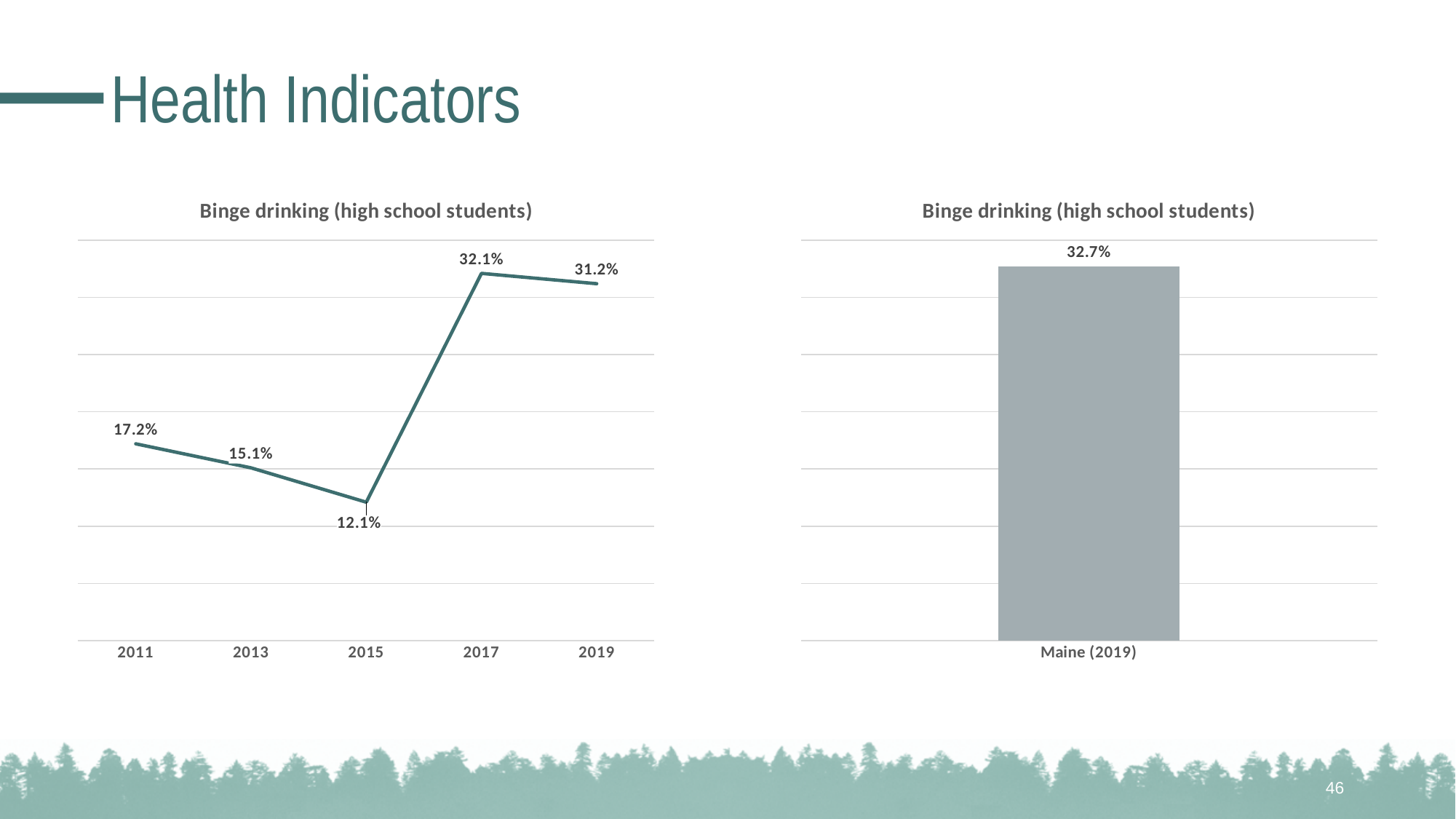
In the left chart, which is larger, the value for 2013 or the value for 2019? 2019 In the left chart, which year has the highest value? 2017 In the left chart, what is the binge drinking value for 2015? 12.1% In the left chart, what is the value for 2011? 17.2% In the left chart, what is the difference between the 2017 and 2015 values? 20 percentage points In the left chart, do the values rise or fall from 2011 to 2015? Fall In the left chart, what is the difference between the 2011 and 2013 values? 2.1 percentage points What kind of chart is the right chart? Bar chart In the left chart, which year has the lowest value? 2015 How many years are plotted in the left chart? 5 In the right chart, what is the value for Maine (2019)? 32.7% In the left chart, what is the value for 2017? 32.1%